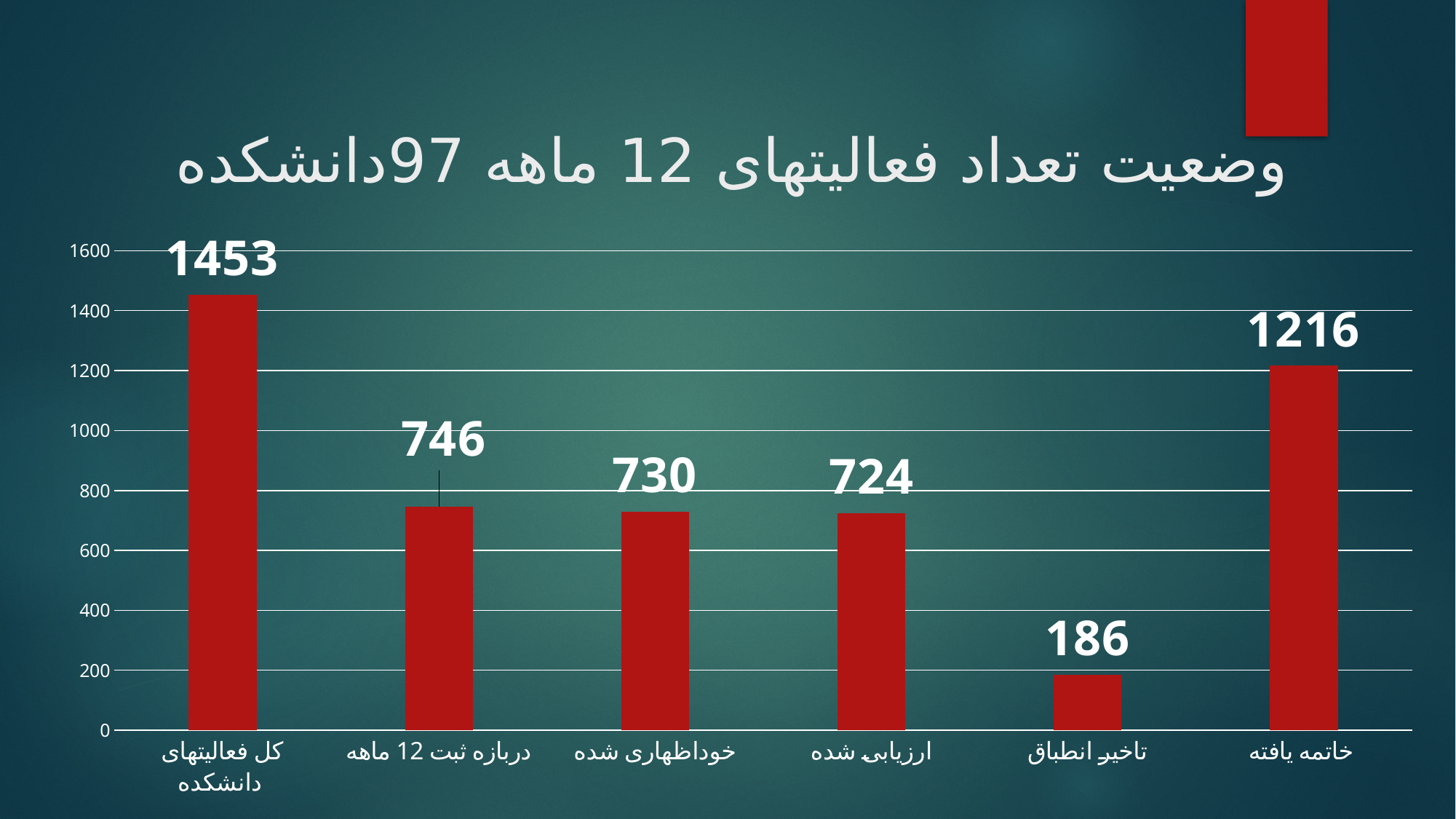
What kind of chart is shown on the slide? bar chart What is the difference between the values for دربازه ثبت 12 ماهه and ارزیابی شده? 22 What is the value for تاخیر انطباق? 186 What is the title of the slide? وضعیت تعداد فعالیتهای 12 ماهه 97دانشکده What is the difference between the values for کل فعالیتهای دانشکده and خاتمه یافته? 237 Which category has the highest value? کل فعالیتهای دانشکده What is the value for کل فعالیتهای دانشکده? 1453 Which is larger, the value for خاتمه یافته or the value for دربازه ثبت 12 ماهه? خاتمه یافته What is the value for خوداظهاری شده? 730 What is the value for خاتمه یافته? 1216 Which category has the lowest value? تاخیر انطباق How many categories are shown in the chart? 6